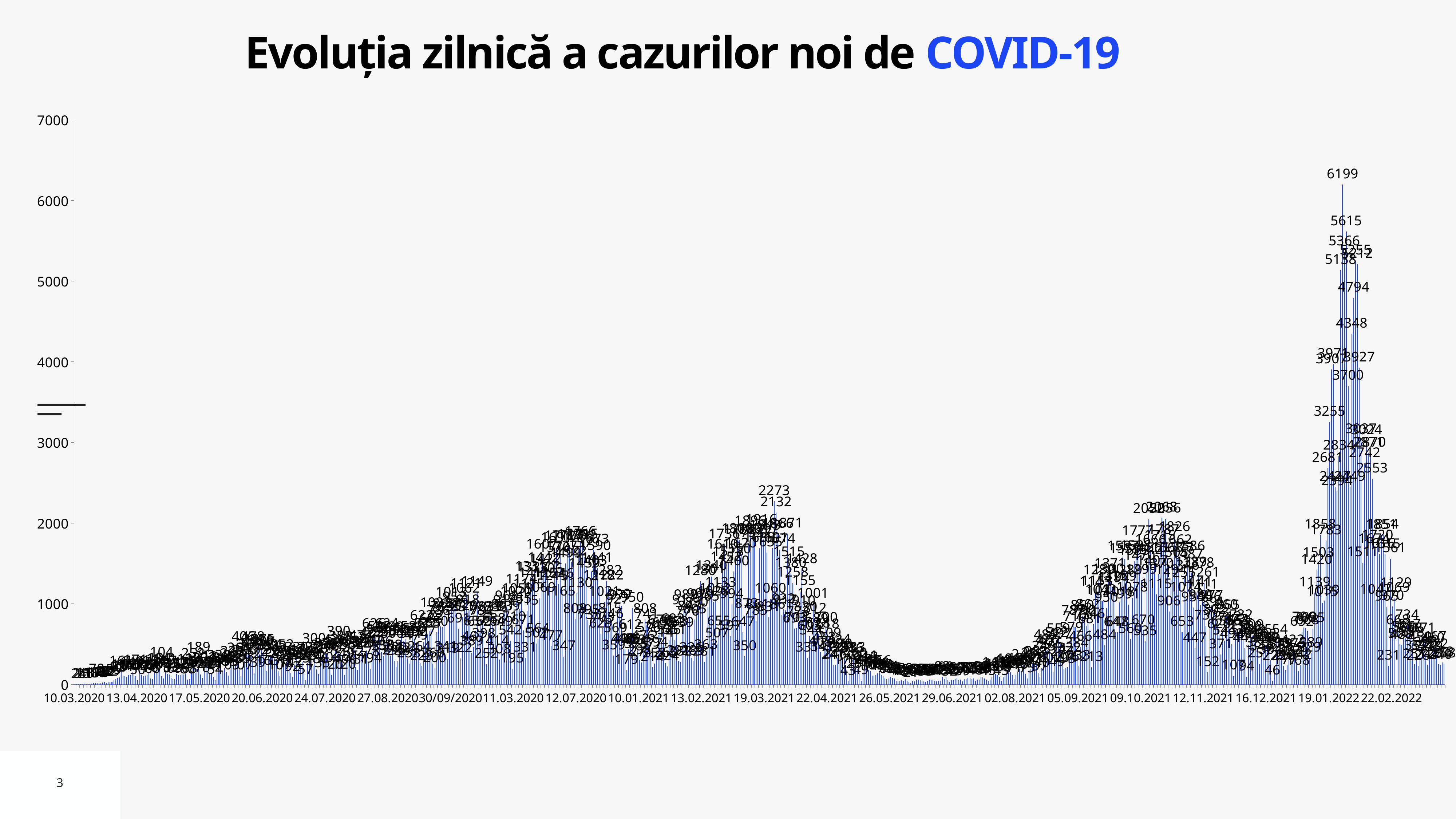
What is the first date shown on the horizontal axis? 10.03.2020 Do the daily values rise or fall between 10.03.2020 and 13.04.2020? rise What kind of chart is shown on the slide? bar chart What is the highest data label in the wave around 19.03.2021? 2273 What is the highest daily value labelled on the chart? 6199 What is the difference between the overall peak value (6199) and the peak of the wave around 19.03.2021 (2273)? 3926 What is the last date shown on the horizontal axis? 22.02.2022 Is the peak of the wave around 19.03.2021 greater or less than 2000? greater Is the highest bar on the chart greater or less than 6000? greater What is the title of the chart? Evoluția zilnică a cazurilor noi de COVID-19 Which is larger: the peak of the wave around 19.01.2022 or the peak of the wave around 19.03.2021? the peak around 19.01.2022 What is the highest value shown on the vertical axis? 7000